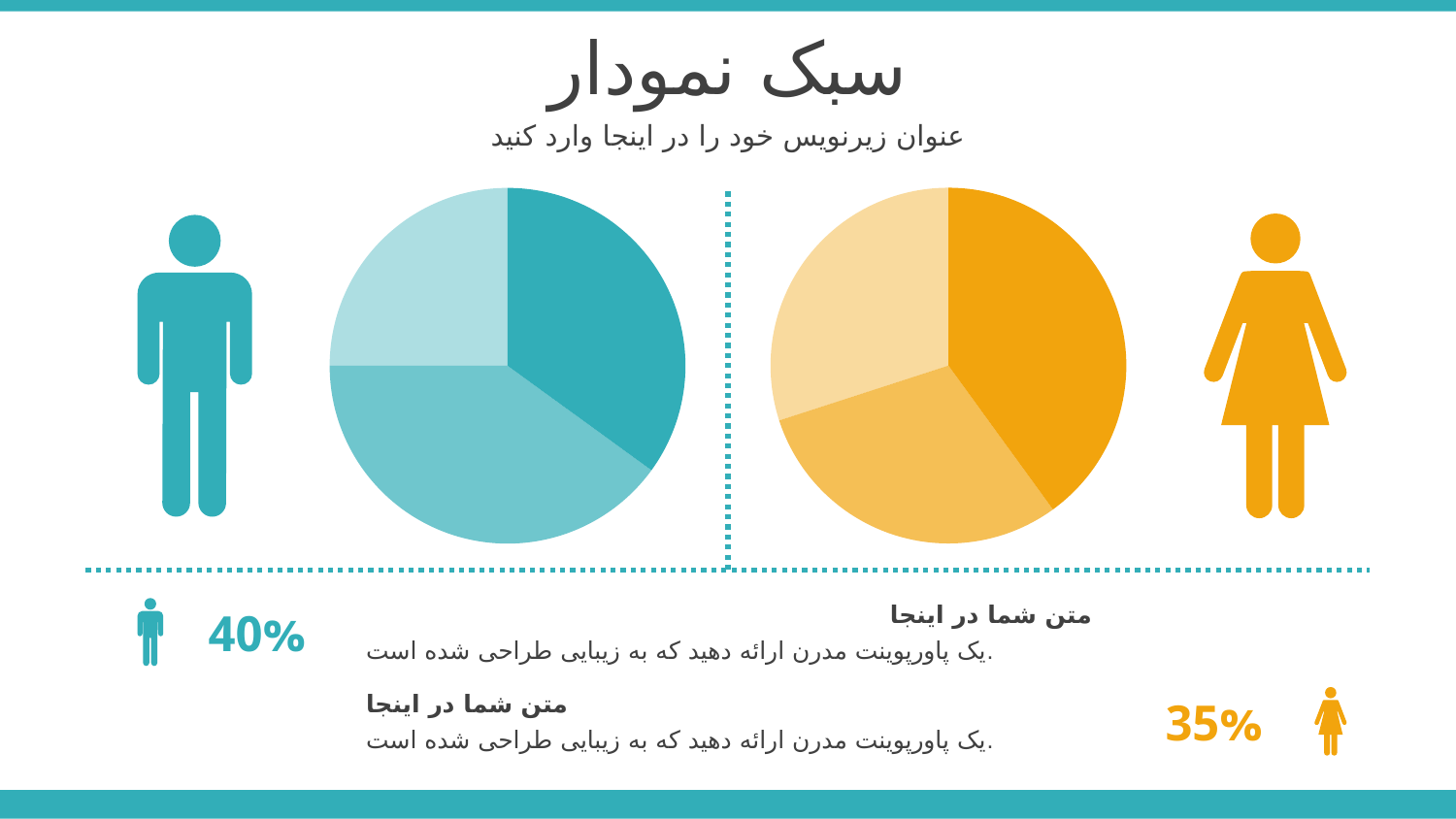
In the left (teal) pie chart, which slice is the largest: the dark teal, the medium teal, or the light teal? Medium teal What kind of chart is the left chart on the slide? Pie chart How many slices does the left (teal) pie chart have? 3 What kind of chart is the right chart on the slide? Pie chart In the right (orange) pie chart, which slice is the largest: the dark orange, the medium orange, or the light orange? Dark orange How many pie charts are shown on the slide? 2 What is the title of the slide above the charts? سبک نمودار What colour scheme is used for the pie chart on the right side of the slide? Orange In the left pie chart, is the dark teal slice larger or smaller than the light teal slice? Larger In the left (teal) pie chart, which slice is the smallest: the dark teal, the medium teal, or the light teal? Light teal How many slices does the right (orange) pie chart have? 3